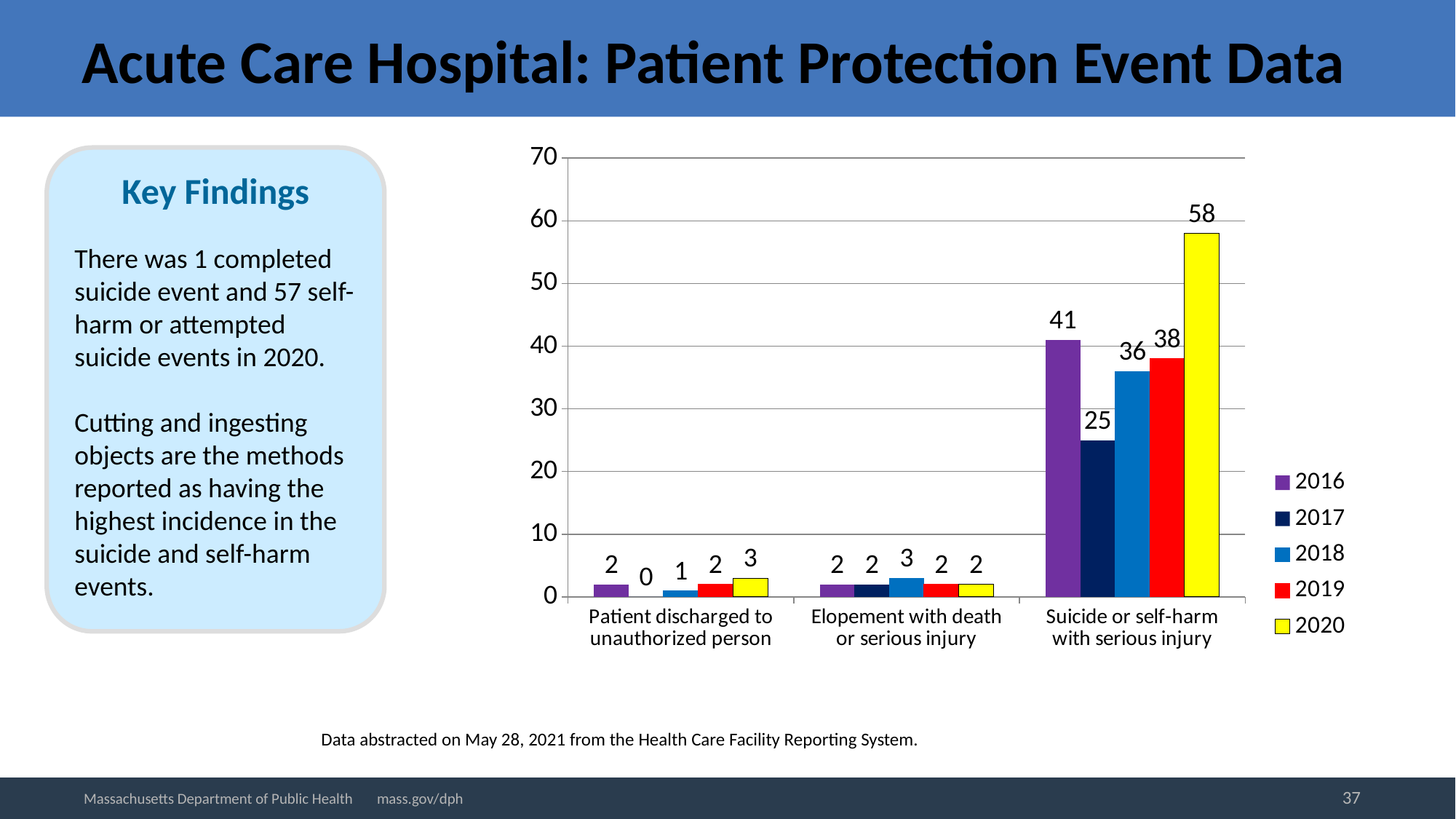
What is the value for 2020 in the 'Suicide or self-harm with serious injury' category? 58 Is the 2020 value for 'Suicide or self-harm with serious injury' greater or less than 50? greater What colour represents the 2020 series in the legend? Yellow What kind of chart is shown on the slide? Bar chart How many series does the legend list? 5 What is the value for 2017 in the 'Patient discharged to unauthorized person' category? 0 Which year has the highest value in the 'Suicide or self-harm with serious injury' category? 2020 What is the difference between the 2020 and 2016 values in the 'Suicide or self-harm with serious injury' category? 17 How many categories are shown on the x axis? 3 In the 'Suicide or self-harm with serious injury' category, which is larger: the 2016 value or the 2019 value? 2016 Which year has the lowest value in the 'Suicide or self-harm with serious injury' category? 2017 What is the value for 2018 in the 'Elopement with death or serious injury' category? 3